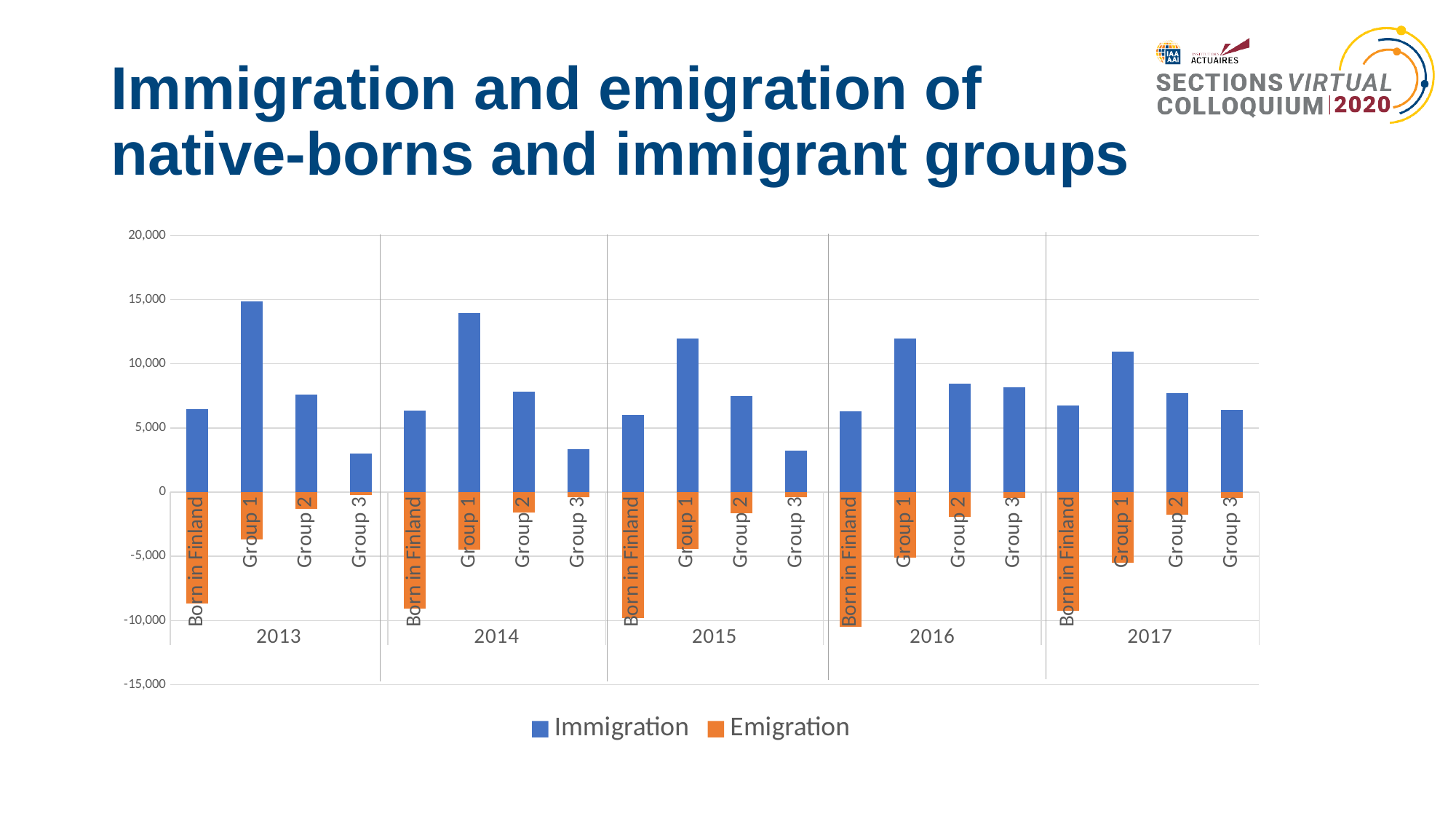
What are the two series named in the legend? Immigration and Emigration Is the Immigration value for Group 3 in 2013 greater or less than 5,000? less What kind of chart is shown on the slide? bar chart Is the Emigration value for Born in Finland in 2015 greater or less than -5,000? less Is the Immigration value for Group 1 in 2013 greater or less than 10,000? greater How many series does the legend list? 2 Which colour represents Emigration in the chart? orange How many categories are shown within each year? 4 Does the Immigration value for Group 1 rise or fall from 2013 to 2017? fall In 2016, which has the larger Immigration value, Group 1 or Group 2? Group 1 Which category and year has the highest Immigration bar? Group 1 in 2013 How many years are shown along the x axis? 5